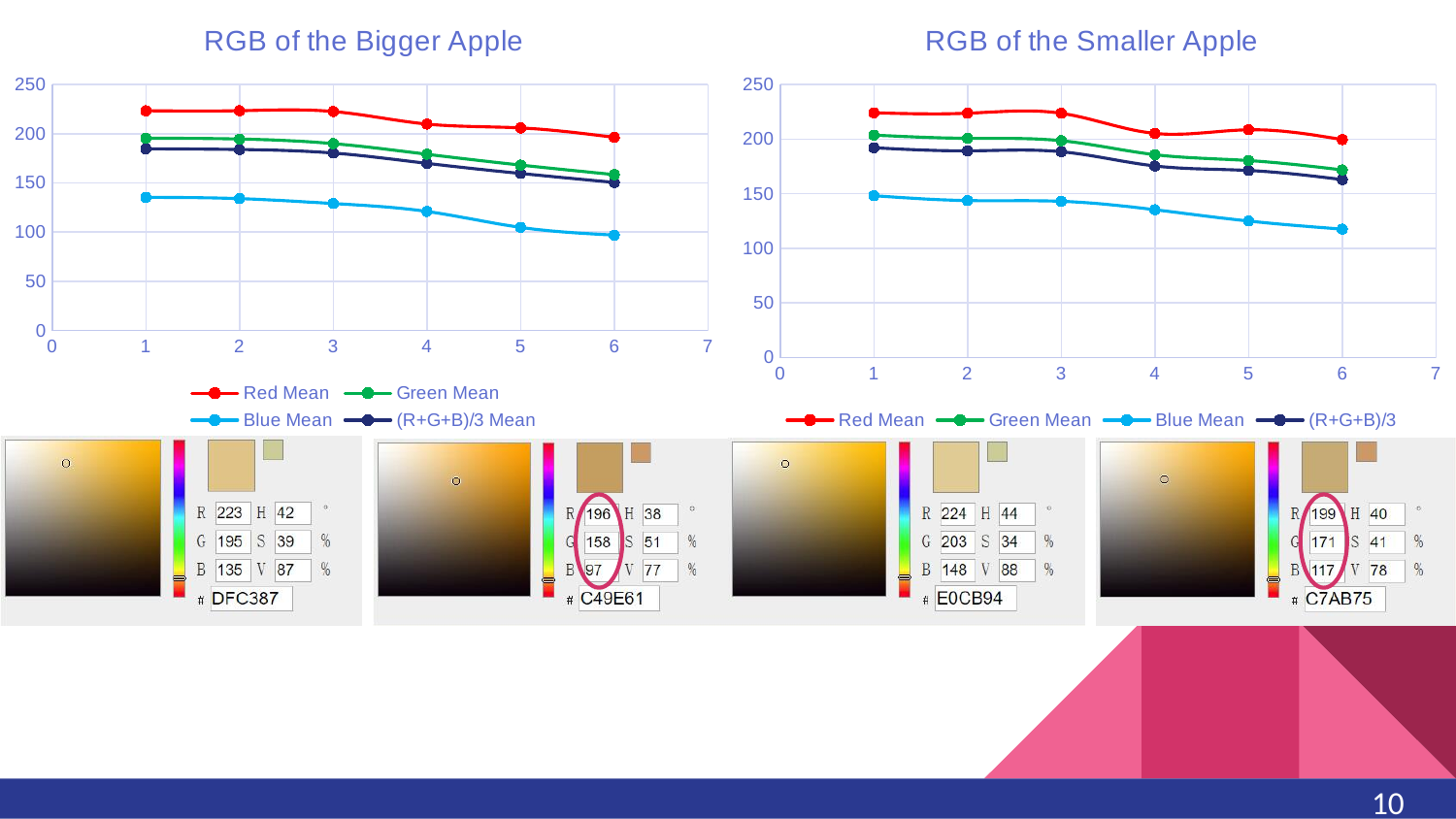
In "RGB of the Bigger Apple", do the Blue Mean values rise or fall from x=1 to x=6? Fall In "RGB of the Bigger Apple", how many data points does the Red Mean series have? 6 How many series does the legend of "RGB of the Smaller Apple" list? 4 In "RGB of the Bigger Apple", which series has the highest values across the x axis? Red Mean In "RGB of the Smaller Apple", which series has the lowest values across the x axis? Blue Mean In "RGB of the Smaller Apple", is the Green Mean value at x=6 greater or less than 150? greater What type of chart is "RGB of the Bigger Apple"? Line chart In "RGB of the Smaller Apple", is the Blue Mean value at x=6 greater or less than 100? greater In "RGB of the Smaller Apple", which is larger: the Blue Mean value at x=1 or at x=6? x=1 In "RGB of the Bigger Apple", is the Red Mean value at x=1 greater or less than 200? greater What is the title of the chart on the right side of the slide? RGB of the Smaller Apple